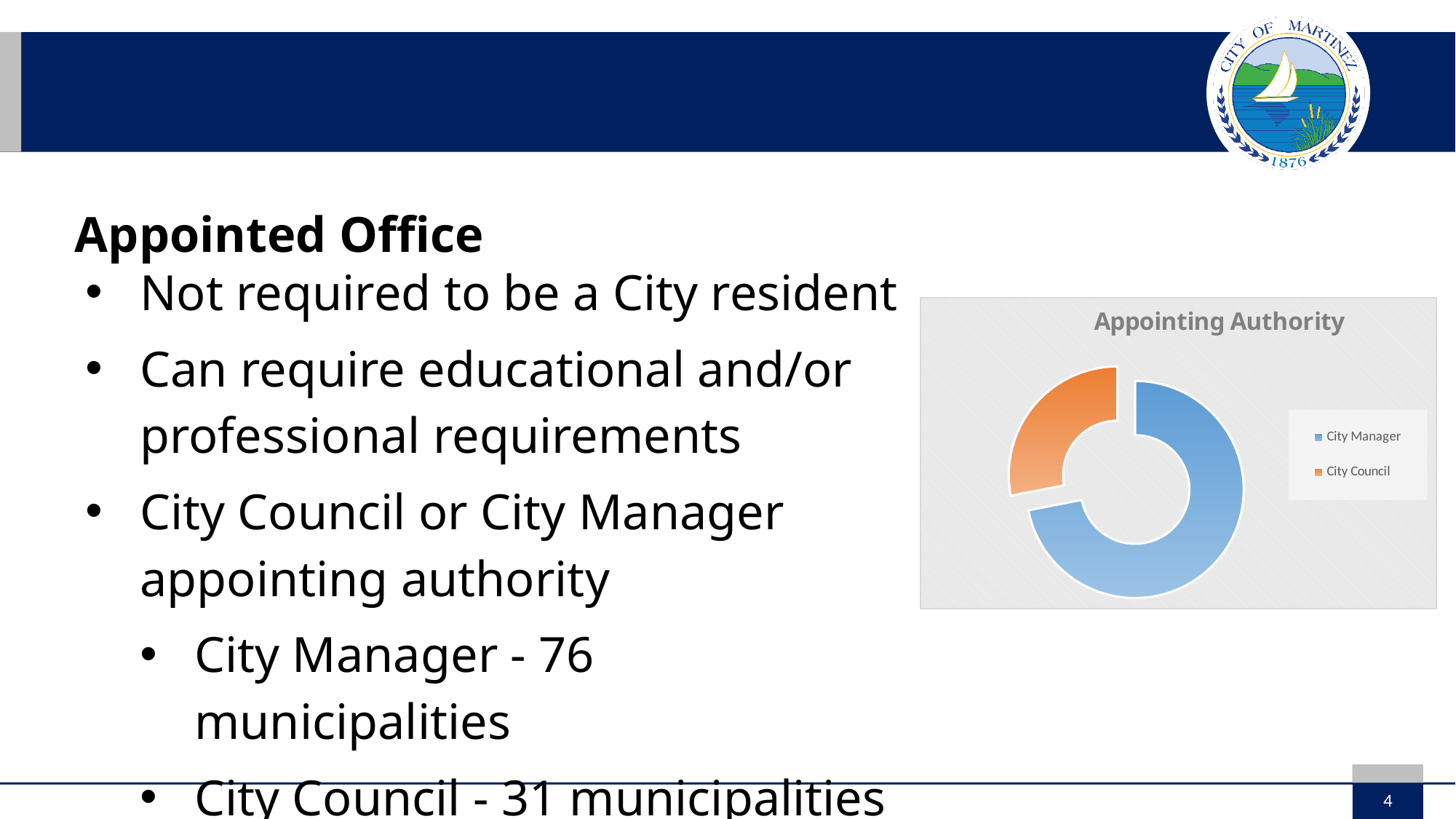
According to the slide, how many municipalities have the City Manager as appointing authority? 76 What colour is the City Council slice in the Appointing Authority chart? orange What type of chart is shown on the slide? doughnut chart How many entries does the legend of the Appointing Authority chart list? 2 According to the slide, how many municipalities have the City Council as appointing authority? 31 In the Appointing Authority chart, which slice is larger: City Manager or City Council? City Manager What is the total number of municipalities represented in the Appointing Authority chart, according to the slide? 107 What is the title of the chart on the slide? Appointing Authority Which category has the smallest slice in the Appointing Authority chart? City Council How many categories does the Appointing Authority chart show? 2 How many more municipalities use the City Manager than the City Council as appointing authority, according to the slide? 45 Which category has the largest slice in the Appointing Authority chart? City Manager